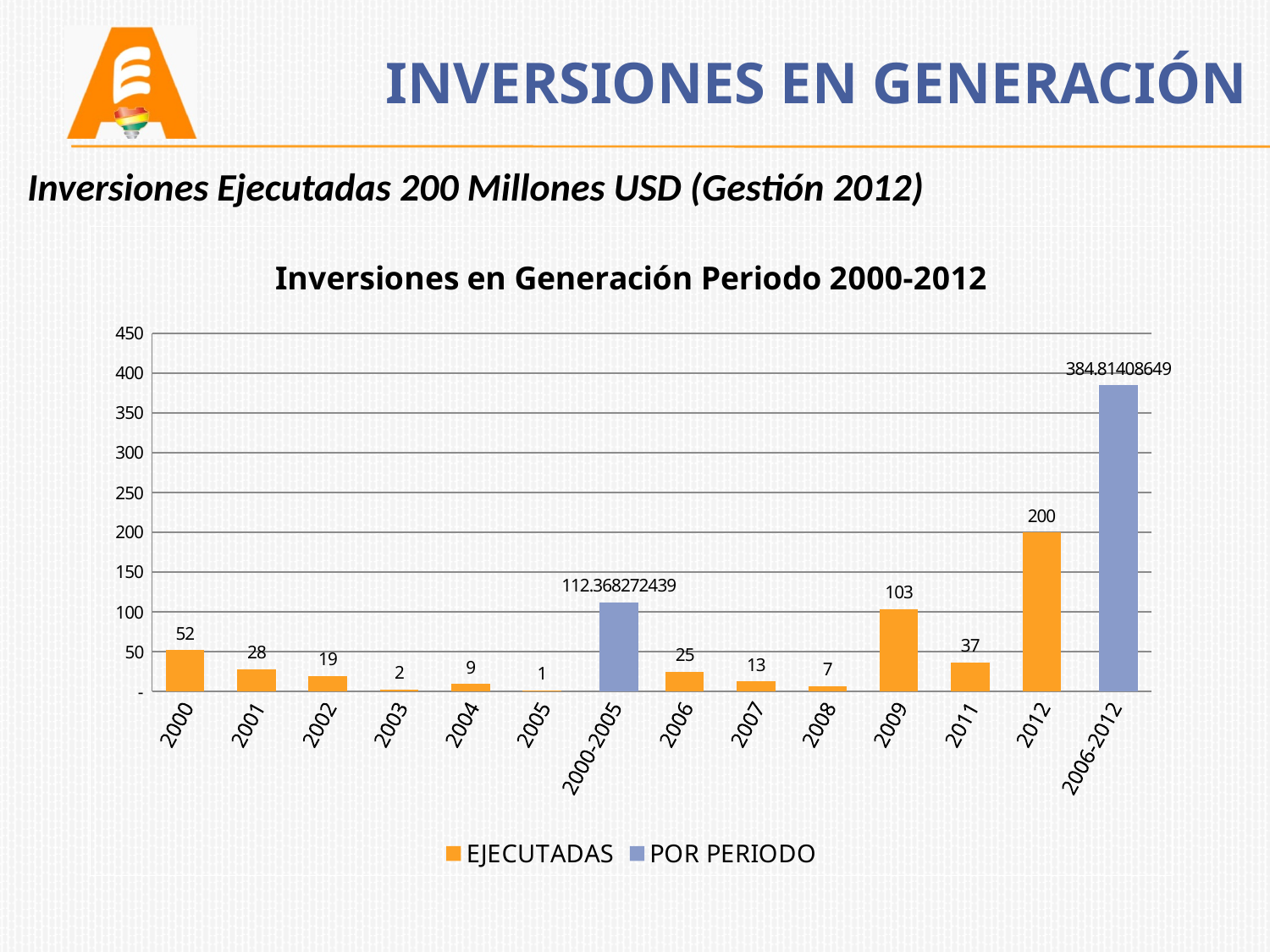
What is the POR PERIODO value for 2006-2012? 384.81408649 Which year has the lowest EJECUTADAS value? 2005 Which year has the highest EJECUTADAS value? 2012 What is the EJECUTADAS value for 2009? 103 What is the EJECUTADAS value for 2012? 200 What is the title of the chart? Inversiones en Generación Periodo 2000-2012 What kind of chart is shown on the slide? Bar chart Which is larger, the EJECUTADAS value for 2000 or for 2011? 2000 What is the POR PERIODO value for 2000-2005? 112.368272439 How many categories are shown on the x axis? 14 How many series does the legend list? 2 What is the difference between the EJECUTADAS values for 2012 and 2009? 97